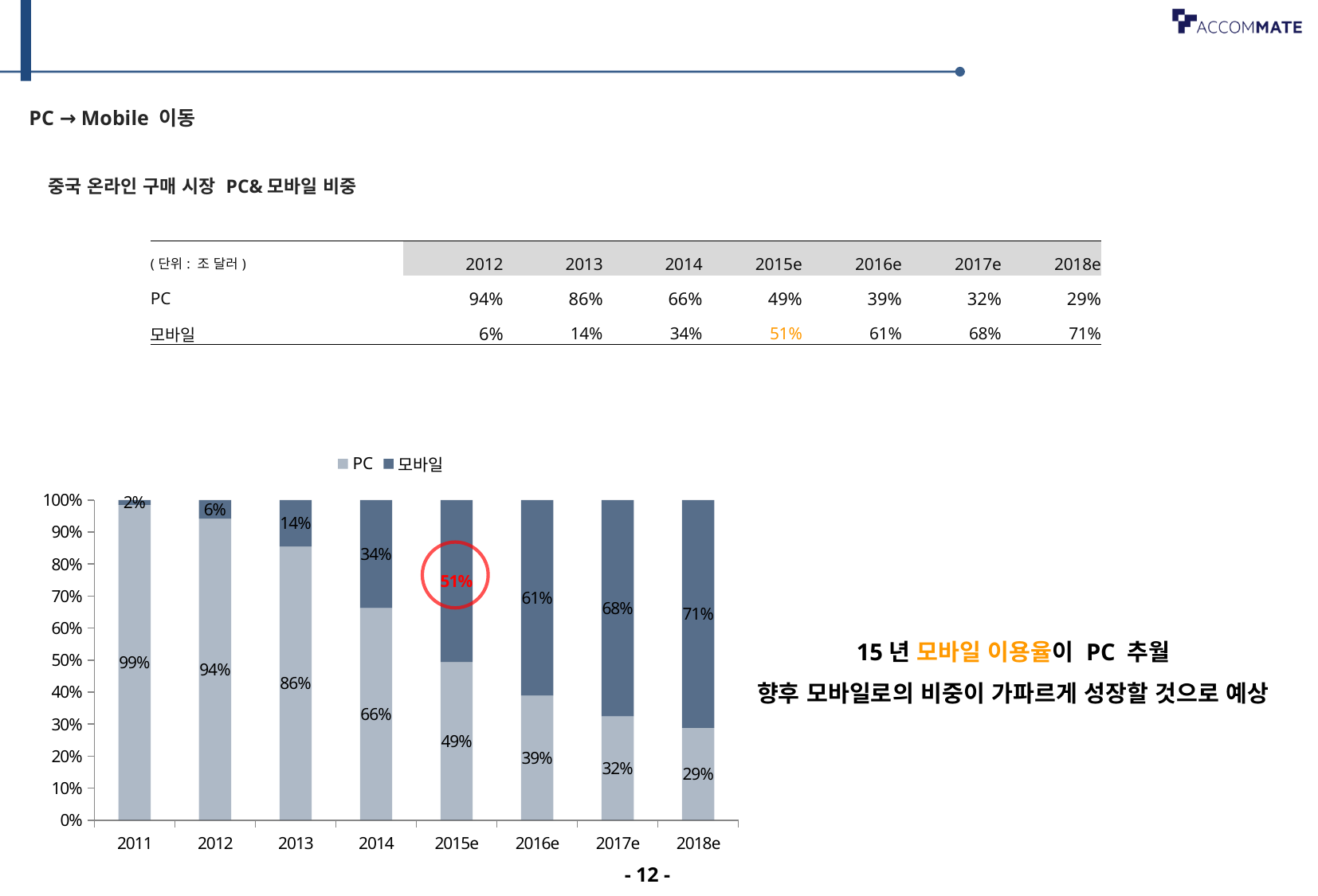
What is the 모바일 value for 2011 in the chart? 2% How many years are shown on the x axis of the chart? 8 What is the difference between the PC value in 2012 and the PC value in 2018e? 65% How many series does the chart legend list? 2 What kind of chart is shown on the slide? Stacked bar chart What is the 모바일 value for 2016e in the chart? 61% In which year is the 모바일 share lowest in the chart? 2011 Which is larger in 2015e, the PC value or the 모바일 value? 모바일 What is the PC value for 2014 in the chart? 66% In which year is the PC share highest in the chart? 2011 Which series is shown in the darker blue colour in the chart? 모바일 Does the PC share rise or fall from 2011 to 2018e? Fall